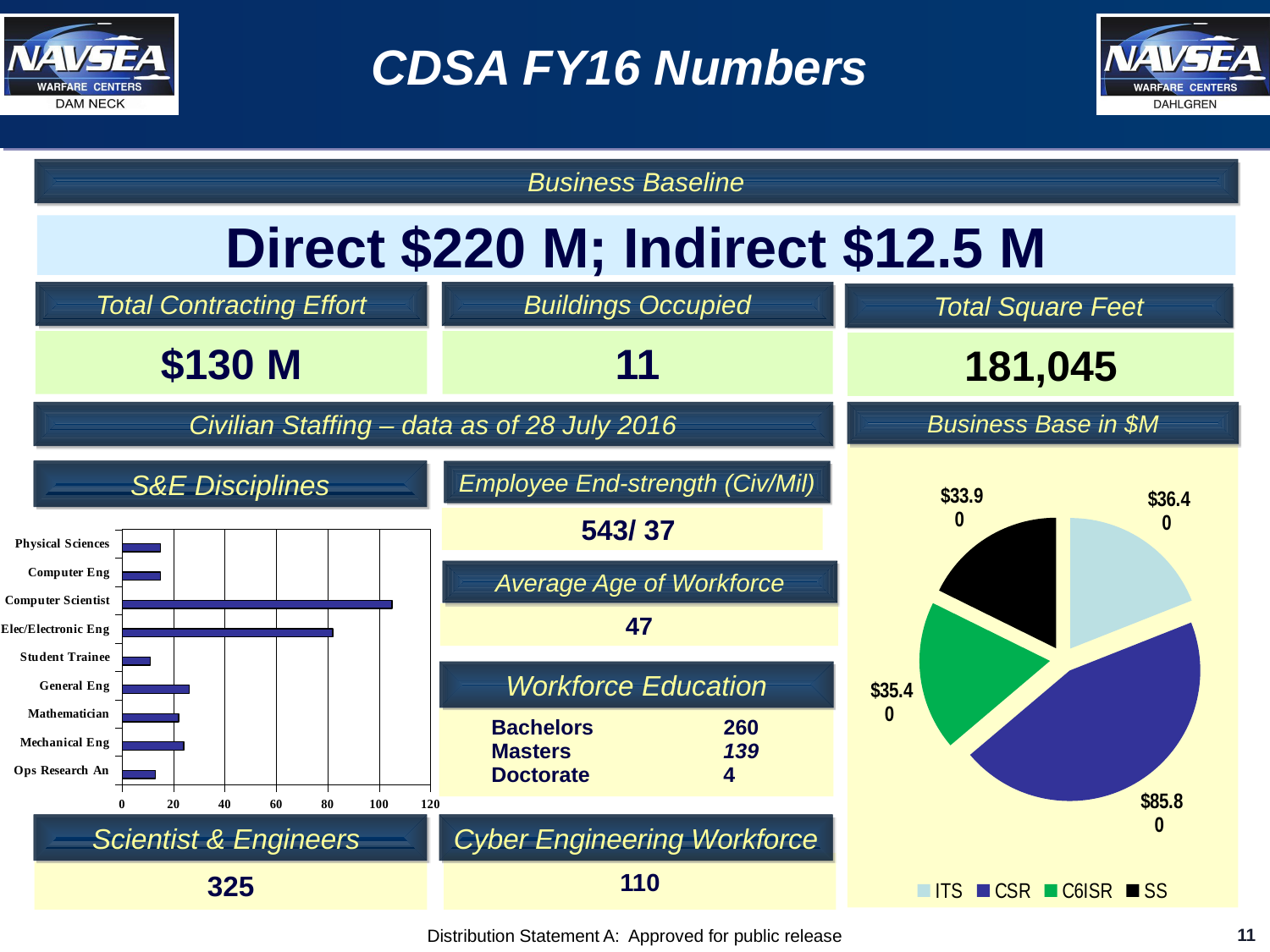
In the S&E Disciplines bar chart, is the value for Computer Scientist greater or less than 100? greater How many entries does the legend of the Business Base in $M pie chart list? 4 What kind of chart is the S&E Disciplines chart? bar chart In the S&E Disciplines bar chart, which discipline has the highest value? Computer Scientist In the S&E Disciplines bar chart, which discipline has the lowest value? Student Trainee In the S&E Disciplines bar chart, is the value for Student Trainee greater or less than 20? less What kind of chart is the Business Base in $M chart? pie chart In the Business Base in $M pie chart, what colour is the SS segment? black In the Business Base in $M pie chart, what is the value for CSR? $85.80 In the Business Base in $M pie chart, which segment is the largest? CSR How many disciplines are shown in the S&E Disciplines bar chart? 9 In the S&E Disciplines bar chart, which is larger, Elec/Electronic Eng or General Eng? Elec/Electronic Eng